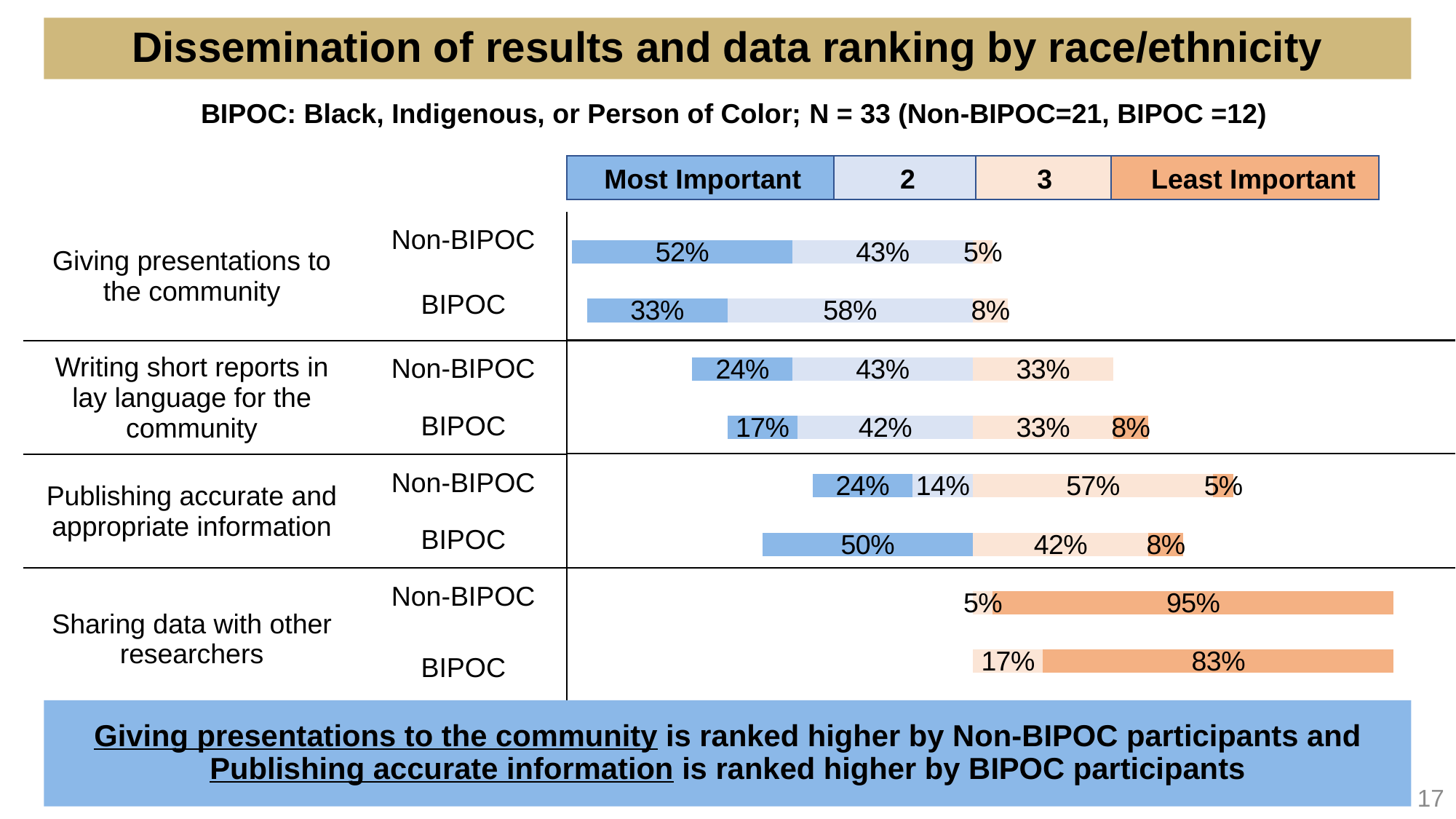
What percentage of BIPOC participants ranked 'Publishing accurate and appropriate information' as Most Important? 50% What kind of chart is shown on the slide? Stacked bar chart For 'Giving presentations to the community', what is the difference in percentage points between the Non-BIPOC and BIPOC Most Important shares? 19 percentage points What percentage of Non-BIPOC participants ranked 'Sharing data with other researchers' as Least Important? 95% Which activity has the highest Least Important share among Non-BIPOC participants? Sharing data with other researchers How many dissemination activities are shown in the chart? 4 What is the title of the slide? Dissemination of results and data ranking by race/ethnicity How many ranking levels does the legend list? 4 What percentage of Non-BIPOC participants ranked 'Publishing accurate and appropriate information' as 3? 57% For 'Publishing accurate and appropriate information', which group has the larger Most Important share, Non-BIPOC or BIPOC? BIPOC What percentage of BIPOC participants ranked 'Giving presentations to the community' as 2? 58% What percentage of Non-BIPOC participants ranked 'Giving presentations to the community' as Most Important? 52%